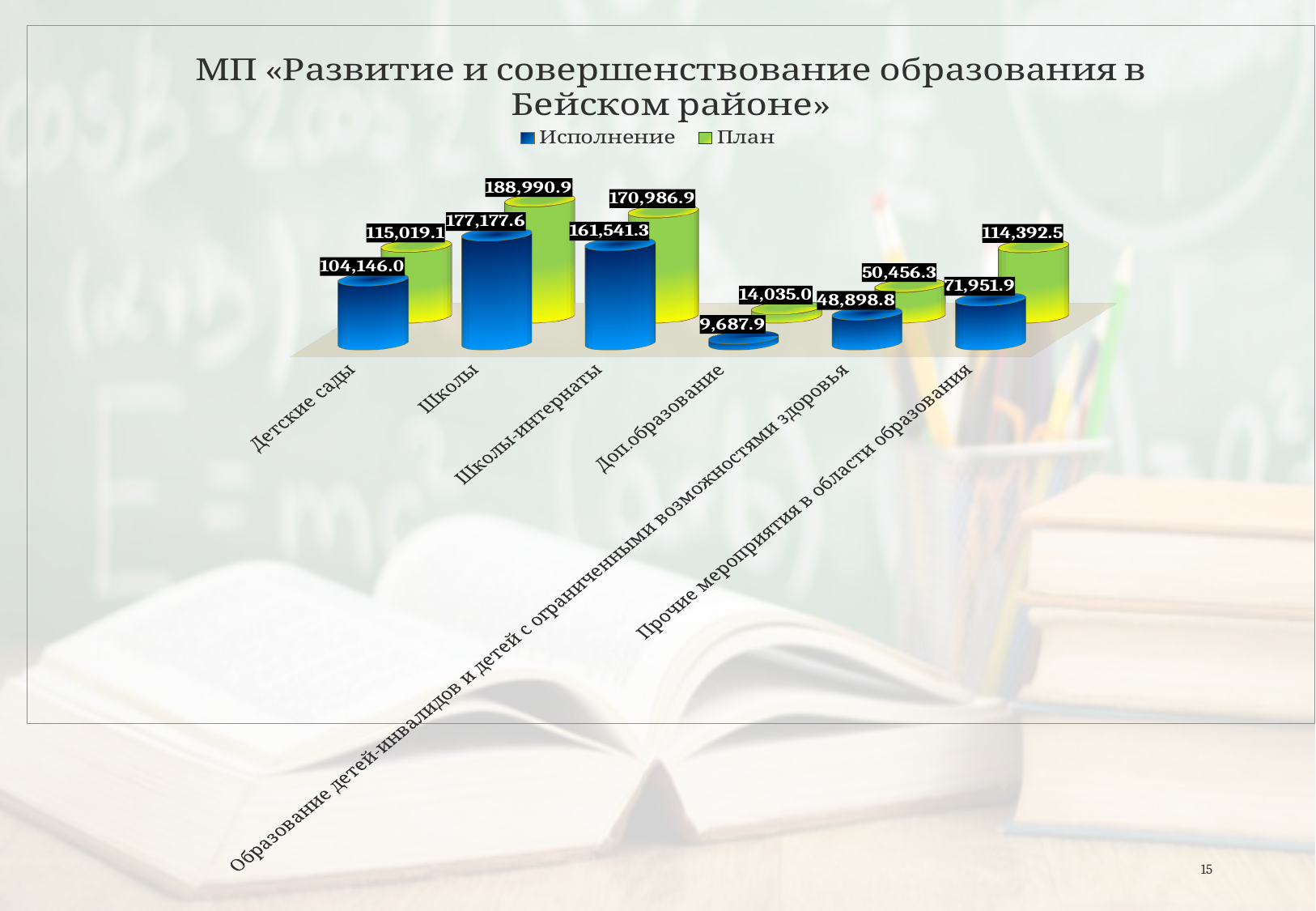
How many series does the legend list? 2 What is the difference between the План and Исполнение values for Школы? 11,813.3 What is the План value for Детские сады? 115,019.1 What is the Исполнение value for Школы? 177,177.6 Which category has the lowest Исполнение value? Доп.образование What is the Исполнение value for Доп.образование? 9,687.9 What is the difference between the План and Исполнение values for Прочие мероприятия в области образования? 42,440.6 What kind of chart is shown on the slide? Bar chart How many categories are shown on the x axis? 6 Which category has the highest План value? Школы What is the План value for Прочие мероприятия в области образования? 114,392.5 Which is larger for Школы-интернаты: the Исполнение value or the План value? План